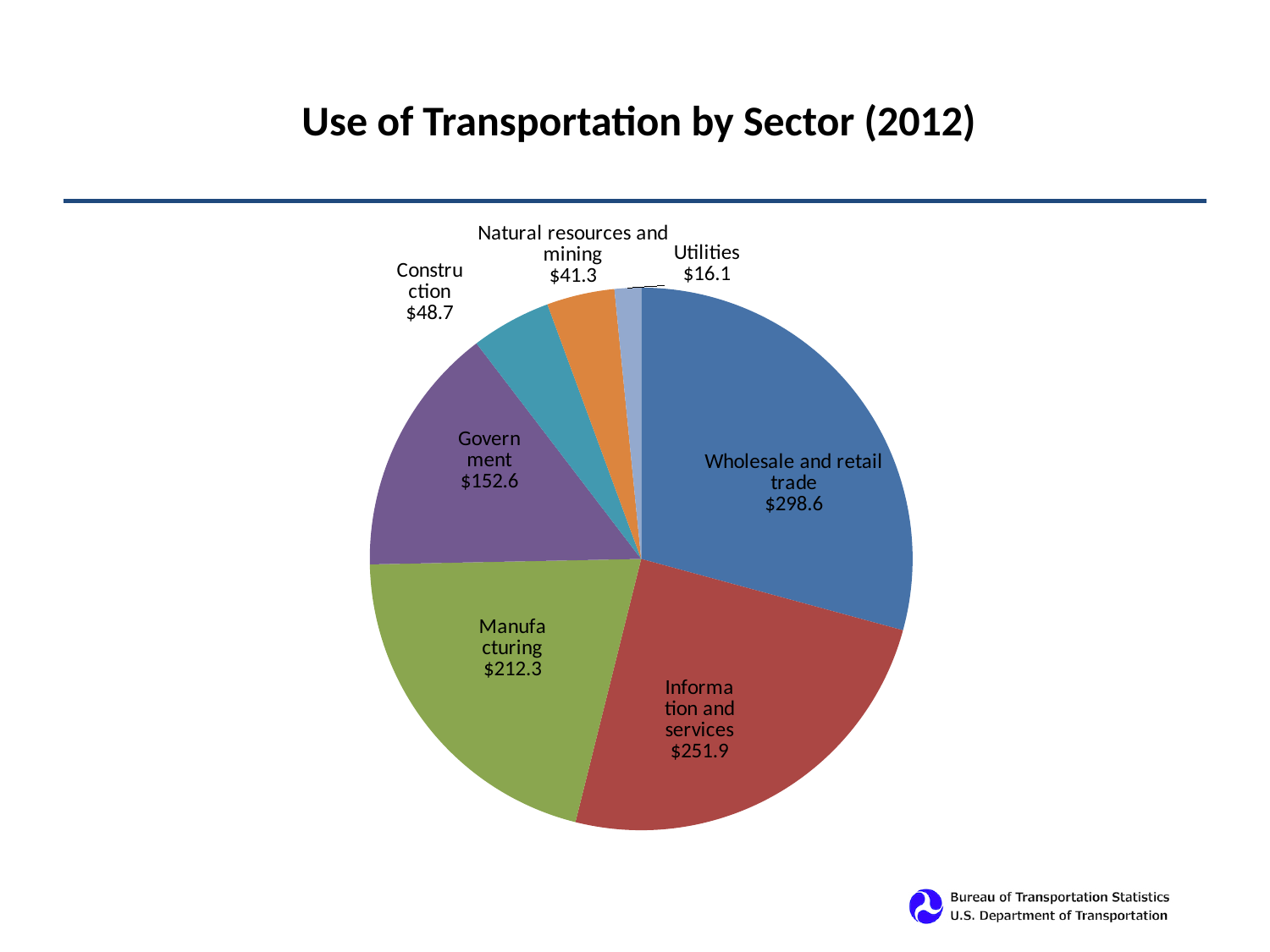
What is the difference between Wholesale and retail trade and Information and services? $46.7 What is the value for Natural resources and mining? $41.3 Which sector has the largest slice of the pie? Wholesale and retail trade Which sector has the smallest slice of the pie? Utilities What is the title of the chart? Use of Transportation by Sector (2012) What is the difference between Manufacturing and Government? $59.7 What type of chart is shown on the slide? Pie chart What is the value for Government? $152.6 Which is larger, Construction or Natural resources and mining? Construction What is the total of all sectors in the pie chart? $1,021.5 How many sectors are shown in the pie chart? 7 What is the value for Wholesale and retail trade? $298.6